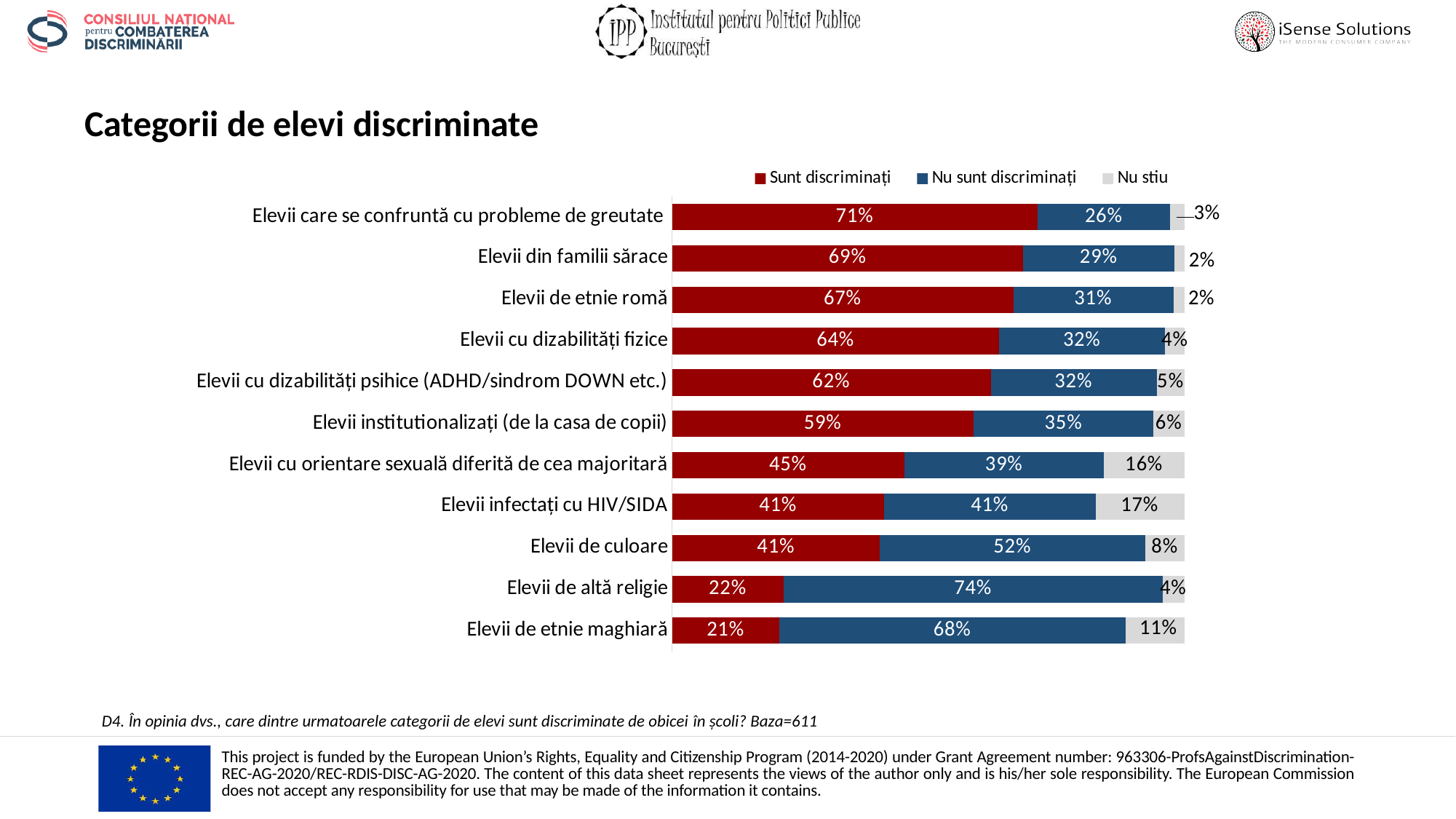
Which category has the highest 'Sunt discriminați' value? Elevii care se confruntă cu probleme de greutate What is the difference between the 'Sunt discriminați' values for 'Elevii de etnie romă' and 'Elevii de culoare'? 26% Which category has the lowest 'Sunt discriminați' value? Elevii de etnie maghiară How many categories of students are shown in the chart? 11 What is the 'Nu sunt discriminați' value for 'Elevii de altă religie'? 74% What kind of chart is shown on the slide? Stacked bar chart How many series does the legend list? 3 What is the title of the chart? Categorii de elevi discriminate What is the 'Nu stiu' value for 'Elevii infectați cu HIV/SIDA'? 17% What percentage of respondents said 'Sunt discriminați' for 'Elevii din familii sărace'? 69% Which is larger: the 'Nu sunt discriminați' value for 'Elevii de culoare' or for 'Elevii de etnie maghiară'? Elevii de etnie maghiară What is the total of the stacked bar for 'Elevii cu orientare sexuală diferită de cea majoritară'? 100%